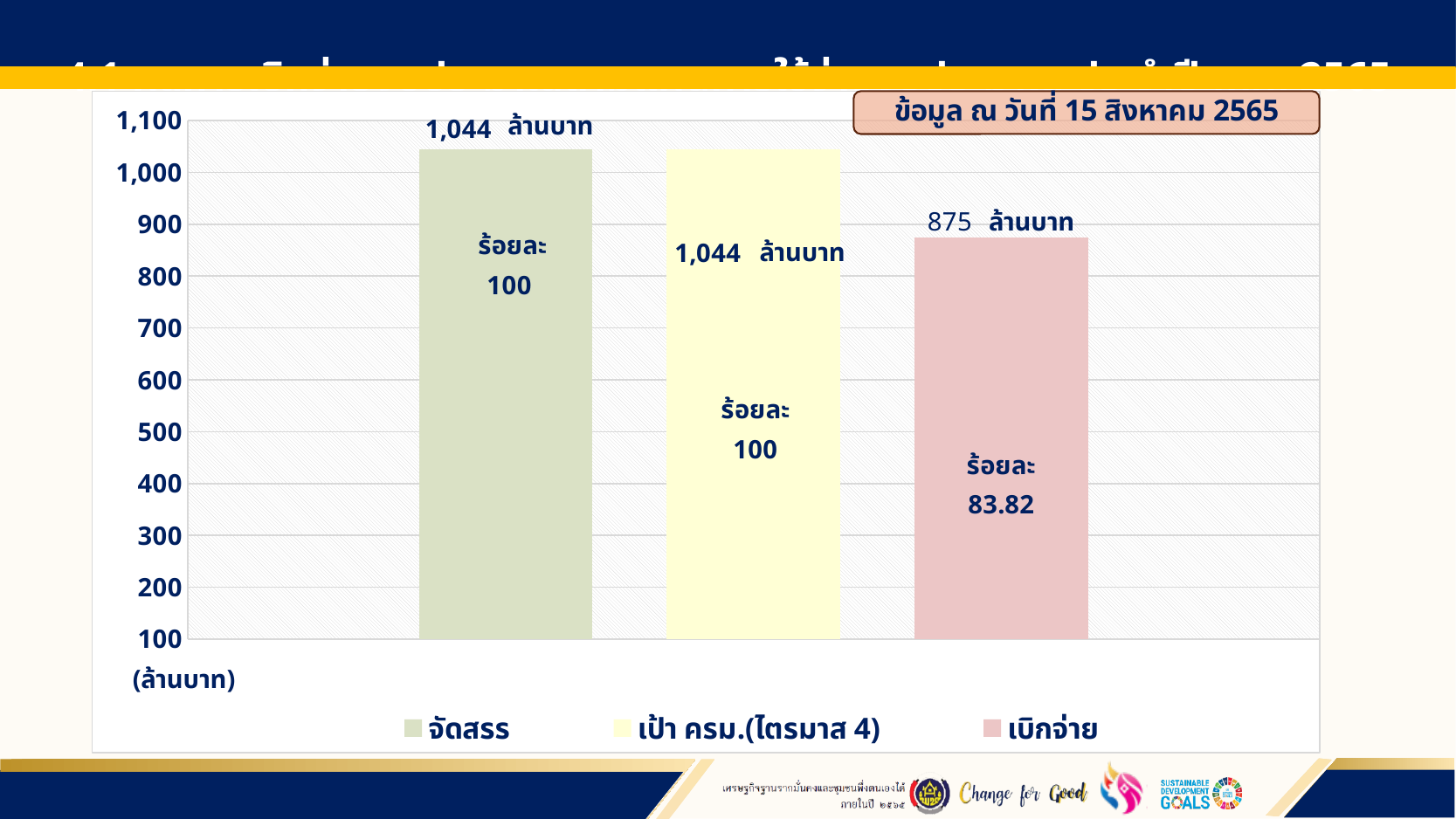
Is the value for เบิกจ่าย greater or less than 900? less Which bar has the lowest value? เบิกจ่าย What percentage (ร้อยละ) is printed on the เบิกจ่าย bar? 83.82 What is the value shown for จัดสรร? 1,044 ล้านบาท How many series does the legend list? 3 How many bars are plotted in the chart? 3 What is the difference between the จัดสรร value and the เบิกจ่าย value? 169 ล้านบาท What percentage (ร้อยละ) is printed on the จัดสรร bar? 100 What is the value shown for เบิกจ่าย? 875 ล้านบาท What is the value shown for เป้า ครม.(ไตรมาส 4)? 1,044 ล้านบาท What kind of chart is shown on the slide? bar chart Which is larger, the value for เป้า ครม.(ไตรมาส 4) or the value for เบิกจ่าย? เป้า ครม.(ไตรมาส 4)